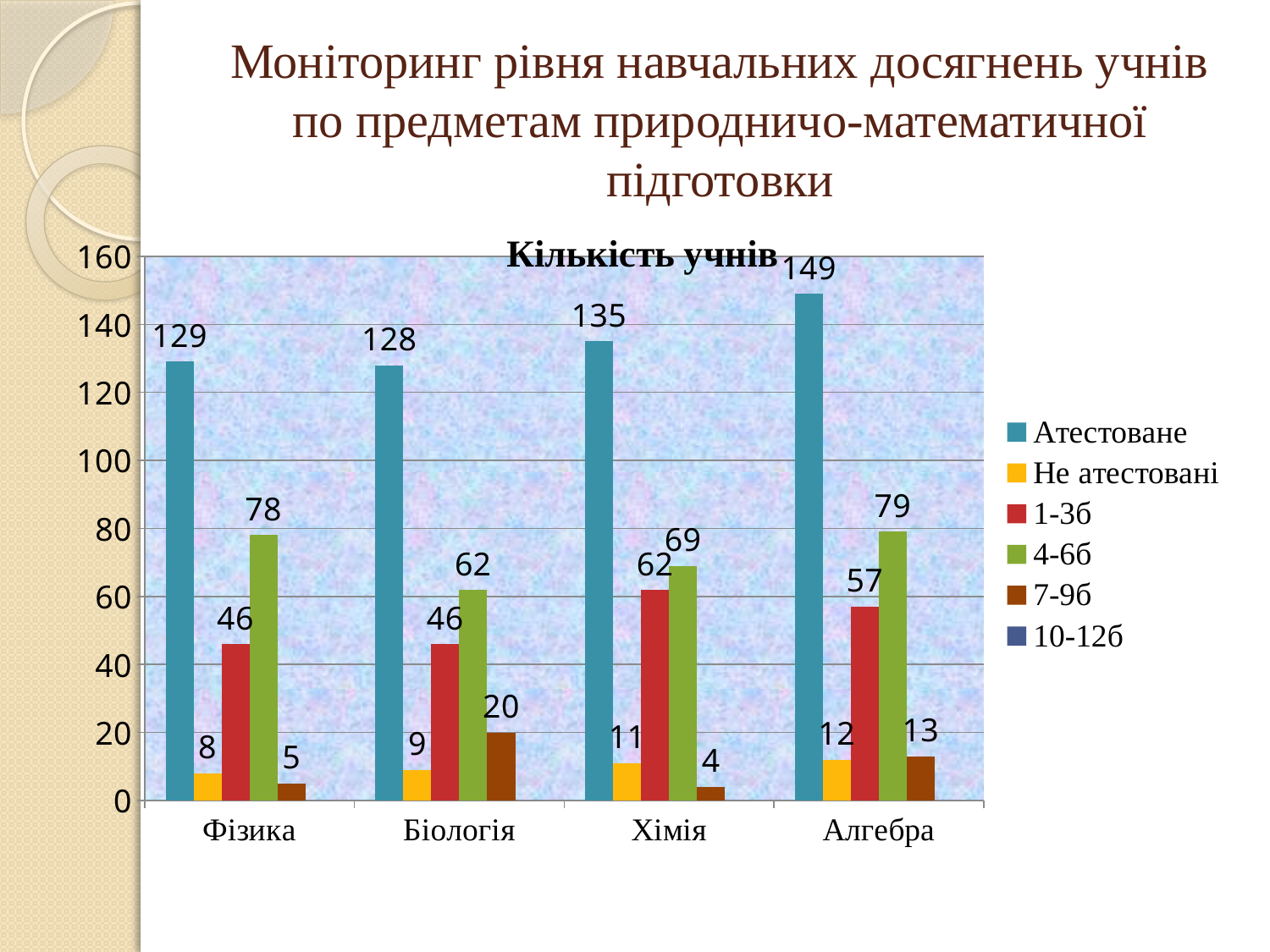
What is the value of Атестоване for Алгебра? 149 What is the value of Не атестовані for Хімія? 11 Which is larger: the 1-3б value for Хімія or the 1-3б value for Алгебра? Хімія How many series does the legend list? 6 What is the difference between the Атестоване values for Алгебра and Біологія? 21 How many subjects are shown on the x axis? 4 Which subject has the highest Атестоване value? Алгебра What kind of chart is shown on the slide? Bar chart Which subject has the lowest 7-9б value? Хімія What is the value of 4-6б for Фізика? 78 What is the value of 7-9б for Біологія? 20 What is the title of the chart? Кількість учнів